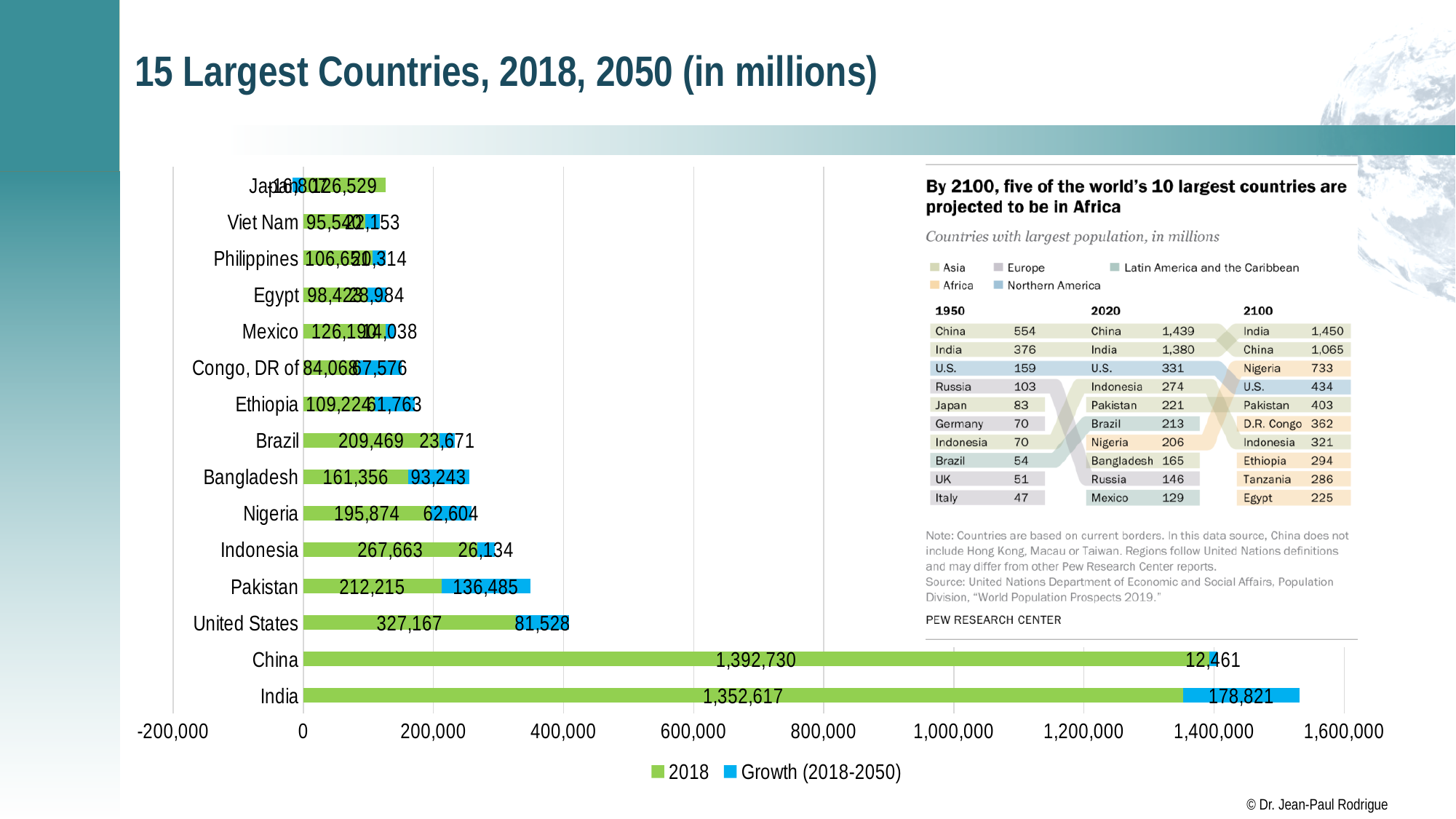
How many countries are plotted in the bar chart? 15 In the bar chart, which has the larger Growth (2018-2050) value, India or China? India In the bar chart, what is the Growth (2018-2050) value for Bangladesh? 93,243 How many series does the legend of the bar chart list? 2 In the bar chart, what is the 2018 value for India? 1,352,617 In the bar chart, which country has the highest 2018 value? China In the bar chart, is the 2018 value for Indonesia greater or less than 200,000? greater In the bar chart, what is the Growth (2018-2050) value for Pakistan? 136,485 In the bar chart, what is the difference between the 2018 values of China and India? 40,113 What kind of chart is shown on the left of the slide? bar chart In the bar chart, what is the 2018 value for the United States? 327,167 In the bar chart, what is the total of the stacked bar for India (2018 plus Growth)? 1,531,438